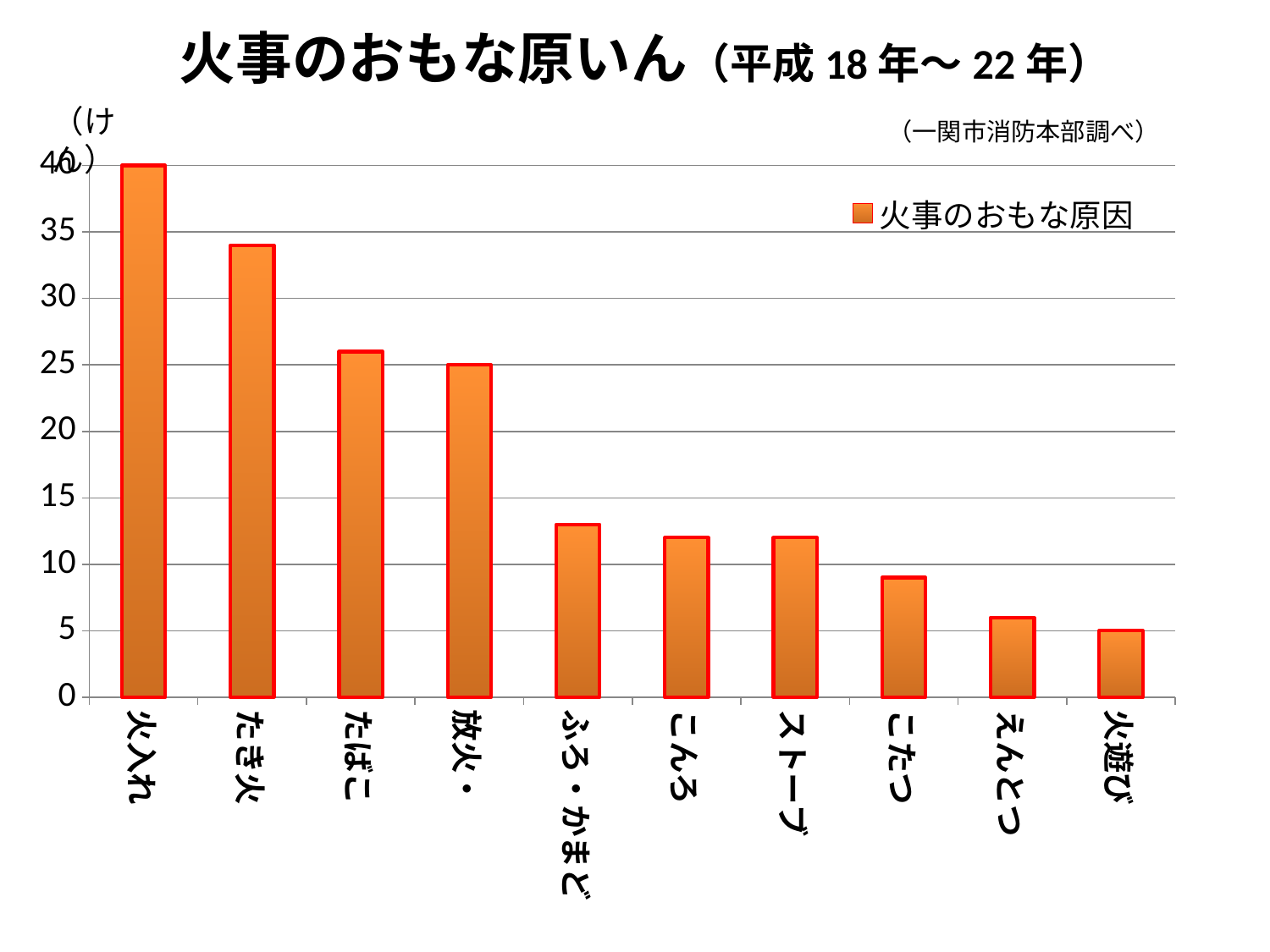
Is the value for たき火 greater or less than 30? greater What is the legend entry shown on the chart? 火事のおもな原因 Which category has the highest value? 火入れ Do the values rise or fall from left to right along the x axis? fall Which category has the lowest value? 火遊び What is the value for 火入れ? 40 How many series does the legend list? 1 Which is larger, the value for たき火 or the value for たばこ? たき火 Is the value for こたつ greater or less than 10? less What kind of chart is shown on the slide? bar chart How many categories are plotted on the chart? 10 What is the value for 火遊び? 5